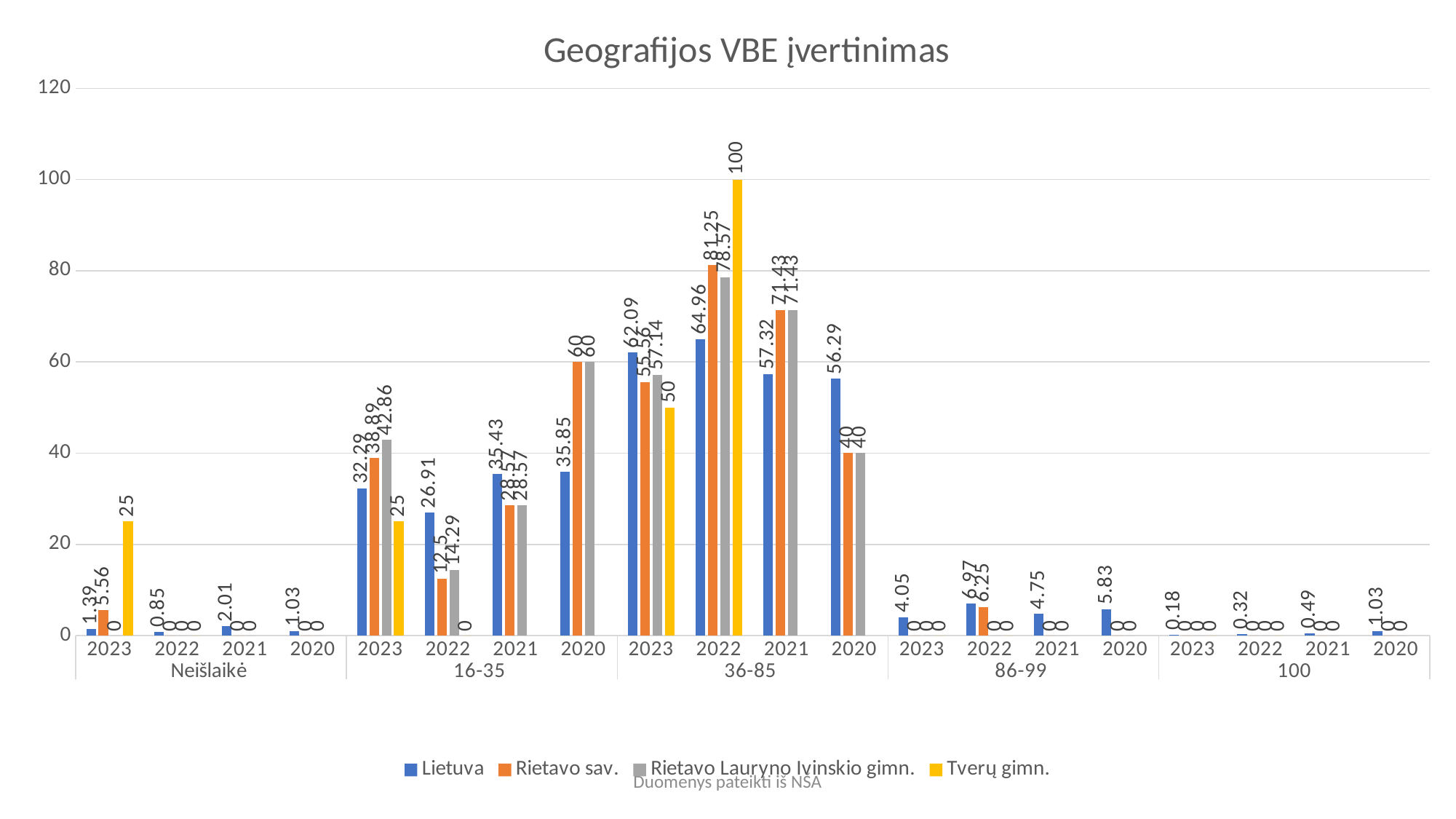
How many series does the legend list? 4 Which is larger in 2020 in the 16-35 group: Lietuva or Rietavo sav.? Rietavo sav. What is the value for Tverų gimn. in 2022 in the 36-85 group? 100 What is the value for Lietuva in 2020 in the 100 group? 1.03 What is the difference between Rietavo sav. and Lietuva in 2022 in the 36-85 group? 16.29 Which series has the highest value in 2022 in the 36-85 group? Tverų gimn. What is the value for Tverų gimn. in 2023 in the Neišlaikė group? 25 What is the value for Lietuva in 2023 in the 16-35 group? 32.29 What is the value for Rietavo sav. in 2022 in the 36-85 group? 81.25 What kind of chart is this? bar chart Is the value for Lietuva in 2023 in the 36-85 group greater or less than 60? greater What is the title of the chart? Geografijos VBE įvertinimas